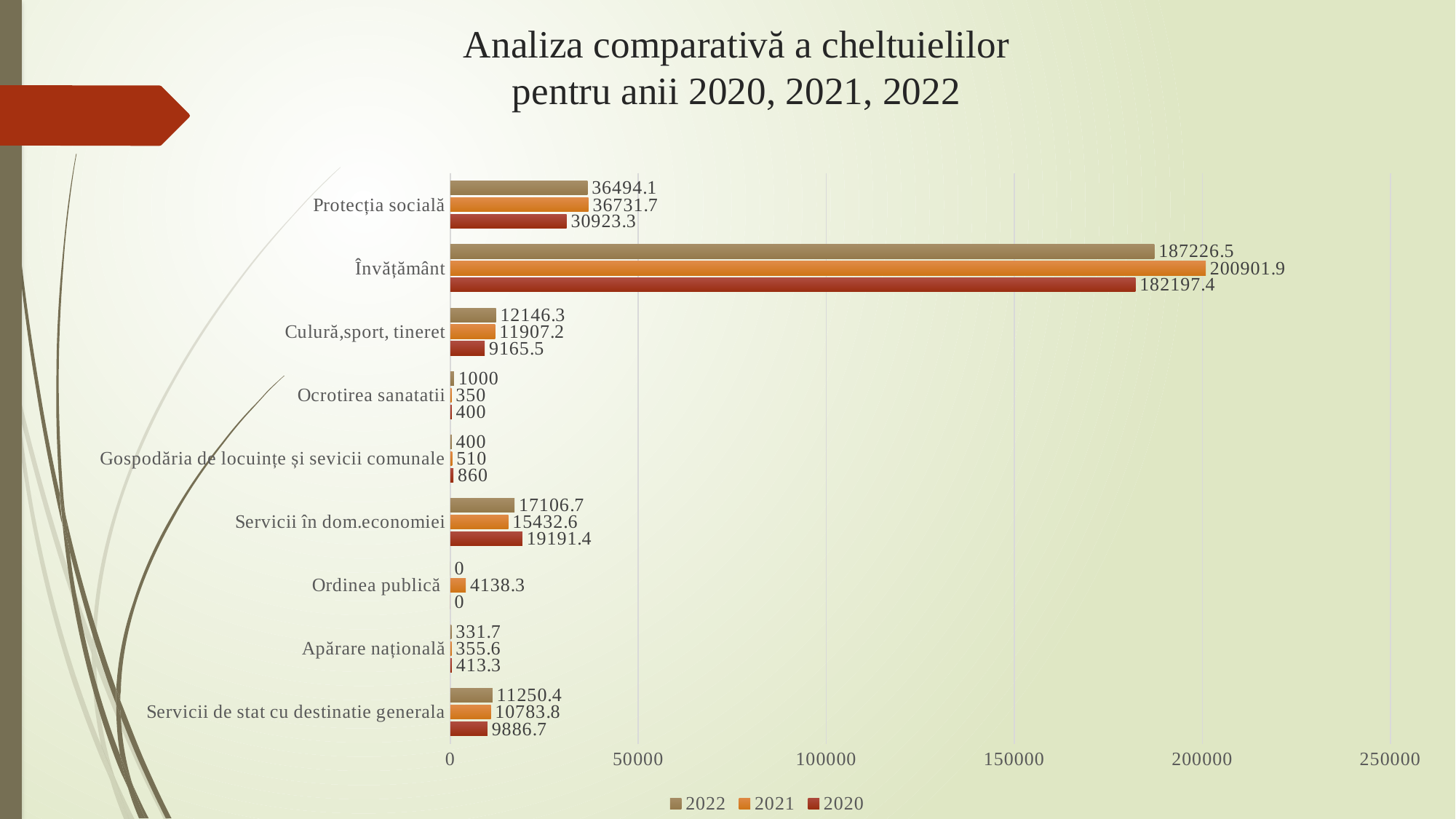
What is the value for Ordinea publică in 2021? 4138.3 What is the value for Servicii de stat cu destinatie generala in 2022? 11250.4 How many series does the legend list? 3 What is the value for Învățământ in 2021? 200901.9 For Gospodăria de locuințe și sevicii comunale, which year has the larger value, 2020 or 2022? 2020 Which category has the highest value in the 2021 series? Învățământ How many categories are shown on the chart? 9 What is the difference between the 2020 and 2021 values for Servicii în dom.economiei? 3758.8 What is the value for Protecția socială in 2020? 30923.3 Which category has the lowest value in the 2022 series? Ordinea publică What is the difference between the 2021 and 2020 values for Învățământ? 18704.5 What kind of chart is shown on the slide? Bar chart